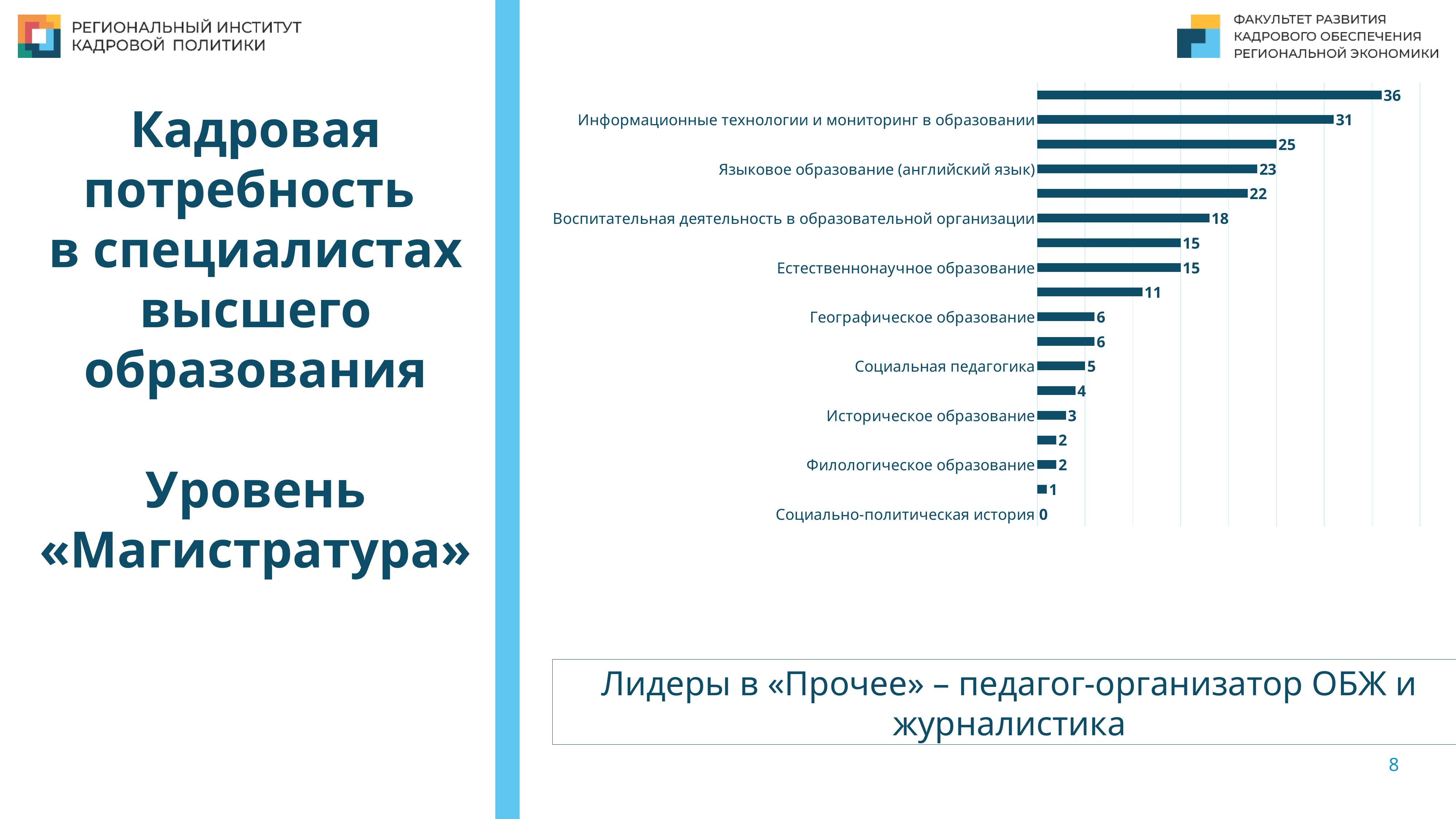
How many bars are plotted on the chart? 18 Which labeled category has the lowest value? Социально-политическая история What is the value for Информационные технологии и мониторинг в образовании? 31 What is the largest value shown on the chart? 36 Which is larger: the value for Географическое образование or the value for Филологическое образование? Географическое образование What is the value for Социальная педагогика? 5 What is the difference between the values for Информационные технологии и мониторинг в образовании and Языковое образование (английский язык)? 8 What is the value for Историческое образование? 3 What type of chart is shown on the slide? bar chart What is the value for Естественнонаучное образование? 15 What is the value for Воспитательная деятельность в образовательной организации? 18 What is the value for Языковое образование (английский язык)? 23